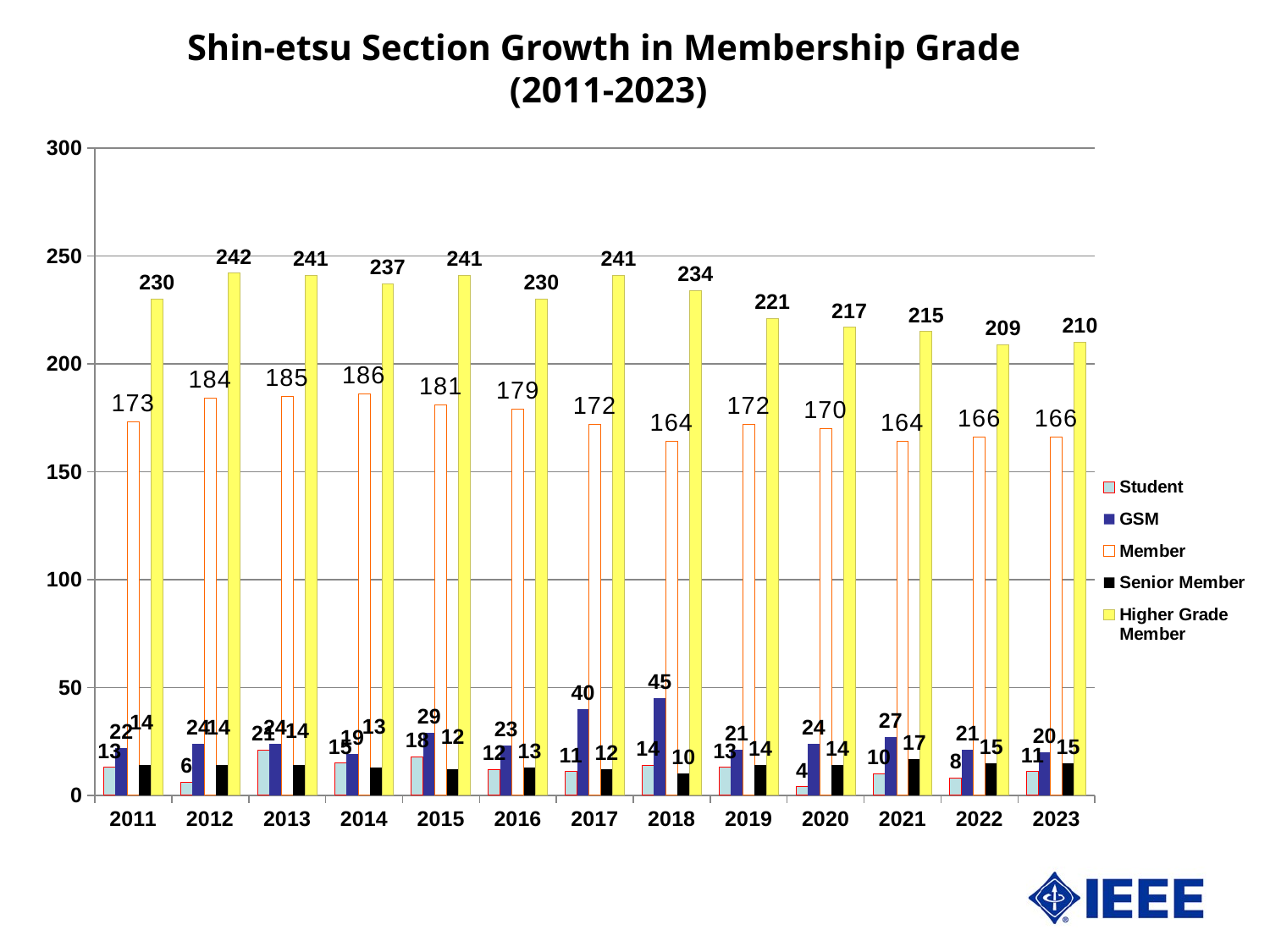
What is the value for Senior Member in 2021? 17 What is the value for GSM in 2018? 45 In which year is the Higher Grade Member value highest? 2012 How many series does the legend list? 5 What is the difference between the Higher Grade Member values in 2012 and 2023? 32 What is the value for Member in 2014? 186 Does the Higher Grade Member value rise or fall from 2017 to 2022? fall Which year has the larger Member value, 2013 or 2019? 2013 In which year is the Student value lowest? 2020 What kind of chart is shown on the slide? bar chart How many years are shown on the x axis? 13 What is the value for Higher Grade Member in 2012? 242